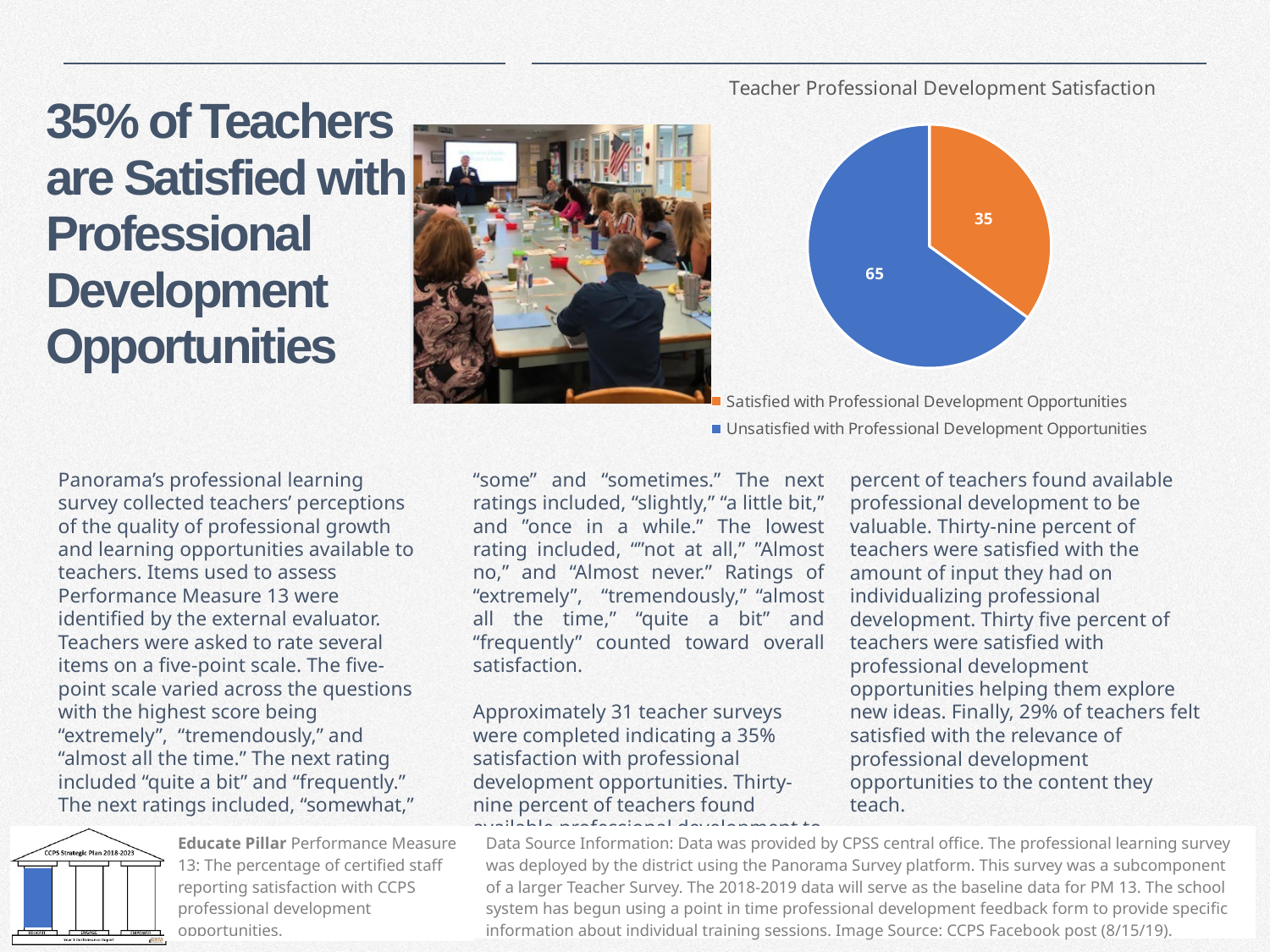
Which is larger, the Satisfied slice or the Unsatisfied slice? Unsatisfied with Professional Development Opportunities What share of the pie does the Satisfied with Professional Development Opportunities slice represent? 35% What colour is the Unsatisfied with Professional Development Opportunities slice? blue Which slice is the largest? Unsatisfied with Professional Development Opportunities What type of chart is shown on the slide? pie chart How many entries does the legend list? 2 What is the difference between the Unsatisfied and Satisfied values? 30 What is the title of the chart? Teacher Professional Development Satisfaction Which slice is the smallest? Satisfied with Professional Development Opportunities What is the value for Satisfied with Professional Development Opportunities? 35 How many slices does the pie chart have? 2 What is the value for Unsatisfied with Professional Development Opportunities? 65